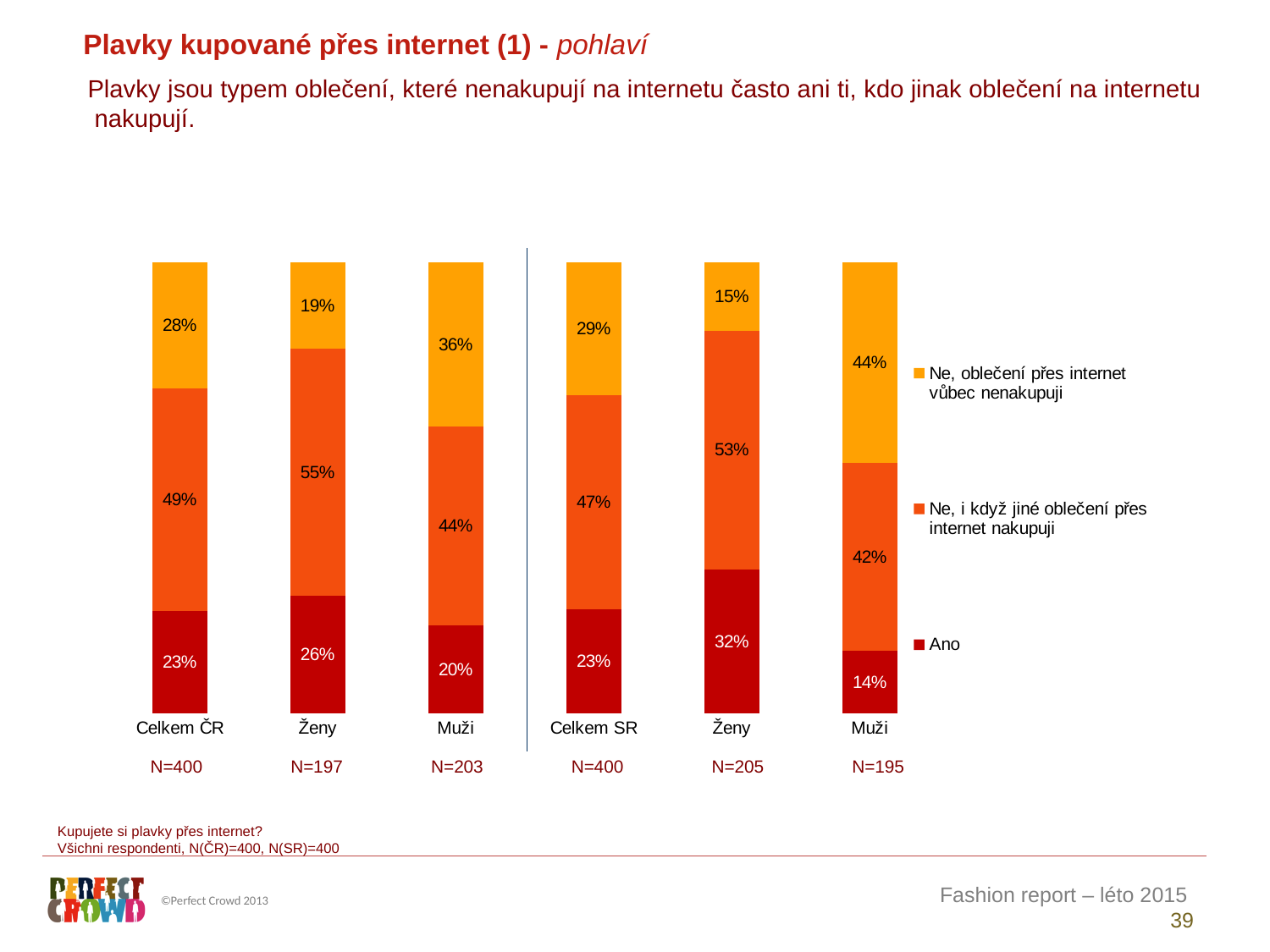
What is the 'Ne, oblečení přes internet vůbec nenakupuji' value for Muži in the SR group (right side)? 44% What is the 'Ano' value for Celkem ČR? 23% Which category has the highest 'Ano' value? Ženy (SR) Which category has the lowest 'Ano' value? Muži (SR) Which is larger: the 'Ne, oblečení přes internet vůbec nenakupuji' value for Muži in the ČR group or for Muži in the SR group? Muži (SR) What is the sample size (N) shown under the Muži bar in the ČR group? N=203 How many series does the legend list? 3 What is the 'Ne, i když jiné oblečení přes internet nakupuji' value for Ženy in the ČR group (left side)? 55% What is the difference between the 'Ano' values for Ženy in the SR group and Ženy in the ČR group? 6% How many bars (categories) are plotted in the chart? 6 What is the total of the stacked bar for Celkem SR? 99% What type of chart is shown on the slide? Stacked bar chart